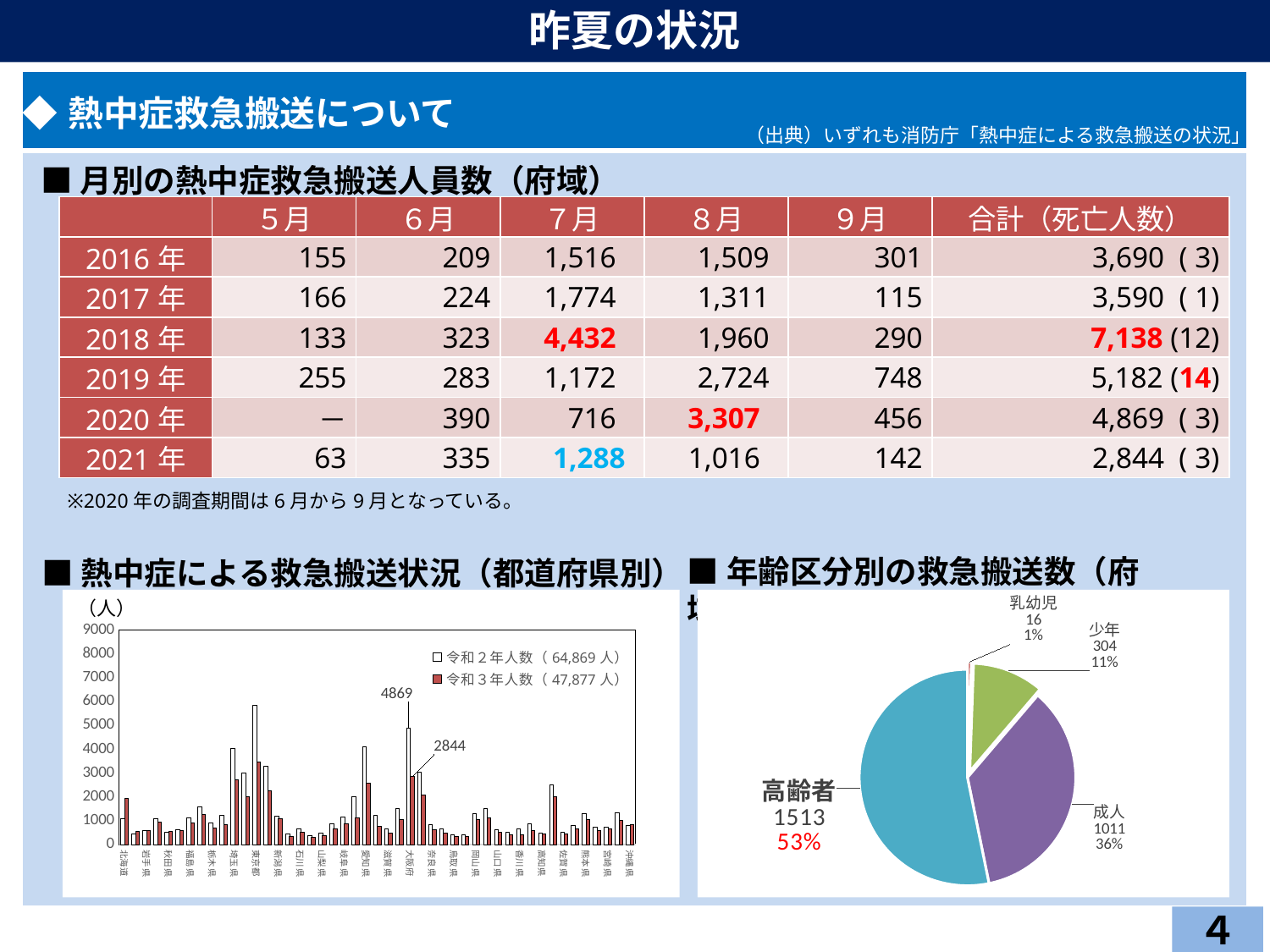
In the bar chart 熱中症による救急搬送状況（都道府県別）, what is the 令和2年 value labelled for 大阪府? 4869 In the pie chart 年齢区分別の救急搬送数, what is the value for 高齢者? 1513 In the pie chart 年齢区分別の救急搬送数, what share of the pie does 高齢者 represent? 53% In the pie chart 年齢区分別の救急搬送数, how many slices are there? 4 In the pie chart 年齢区分別の救急搬送数, what is the difference between the values for 高齢者 and 成人? 502 In the bar chart 熱中症による救急搬送状況（都道府県別）, is the 令和2年 value for 東京都 greater or less than 5000? greater In the bar chart 熱中症による救急搬送状況（都道府県別）, how many series does the legend list? 2 In the pie chart 年齢区分別の救急搬送数, what is the value for 少年? 304 What kind of chart is 熱中症による救急搬送状況（都道府県別）? bar chart In the bar chart 熱中症による救急搬送状況（都道府県別）, what is the 令和3年 value labelled for 大阪府? 2844 In the pie chart 年齢区分別の救急搬送数, what share of the pie does 成人 represent? 36% In the pie chart 年齢区分別の救急搬送数, which age group has the smallest slice? 乳幼児